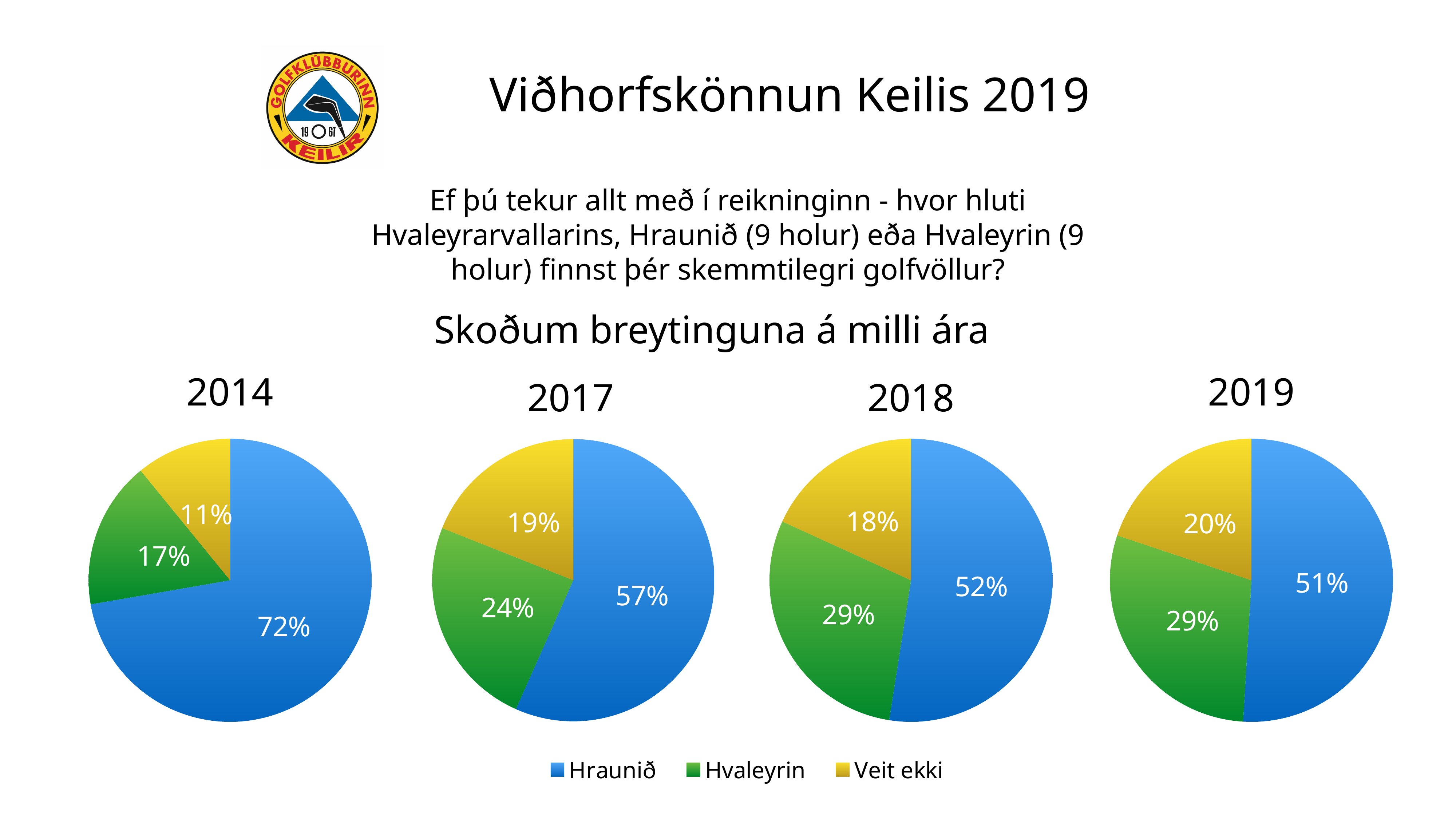
In the 2017 pie chart, what share does Hvaleyrin have? 24% In the 2017 pie chart, what is the difference between the Hraunið share and the Hvaleyrin share? 33% How many pie charts are shown on the slide? 4 In the 2018 pie chart, what share does Veit ekki have? 18% In the 2014 pie chart, what share does Hraunið have? 72% In the 2019 pie chart, what share does Hraunið have? 51% How many series does the legend list? 3 In the 2014 pie chart, which category has the smallest share? Veit ekki What kind of chart is used for the 2014 data? Pie chart In the 2018 pie chart, which is larger, the Hvaleyrin share or the Veit ekki share? Hvaleyrin In the 2019 pie chart, which category has the largest share? Hraunið Across the pie charts from 2014 to 2019, does the Hraunið share rise or fall? Fall